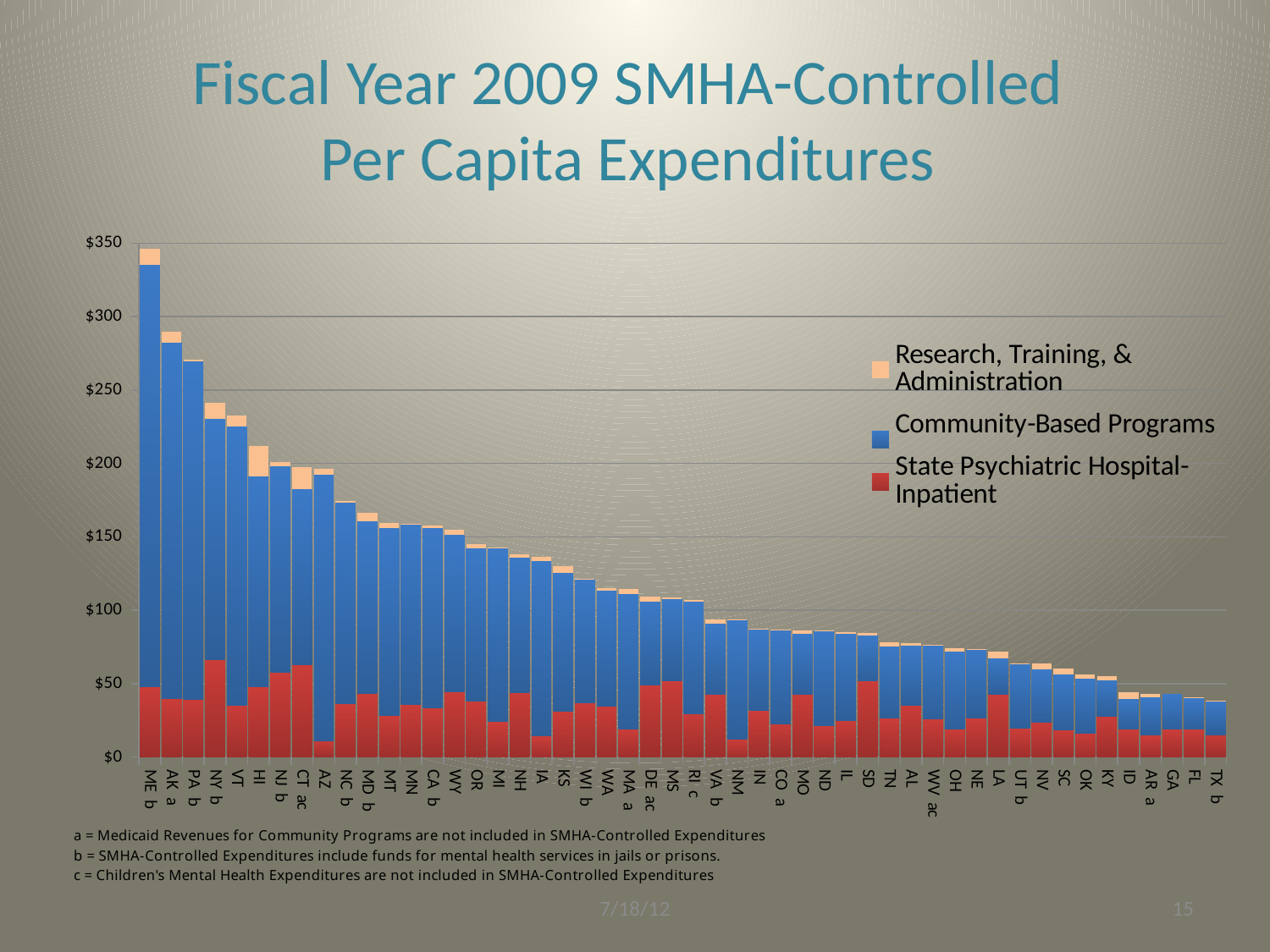
How many series does the legend list? 3 Which has a larger total per capita expenditure, ME b or AK a? ME b Is the total value for TX b greater or less than $50? less Which state has the highest total per capita expenditure? ME b What kind of chart is shown on the slide? Stacked bar chart Do the total values rise or fall moving from left to right along the x axis? fall How many states are shown on the x axis? 50 Is the total value for ME b greater or less than $300? greater Which series is shown in blue in the legend? Community-Based Programs Is the total value for MD b greater or less than $200? less Which has a larger total per capita expenditure, NY b or HI? NY b